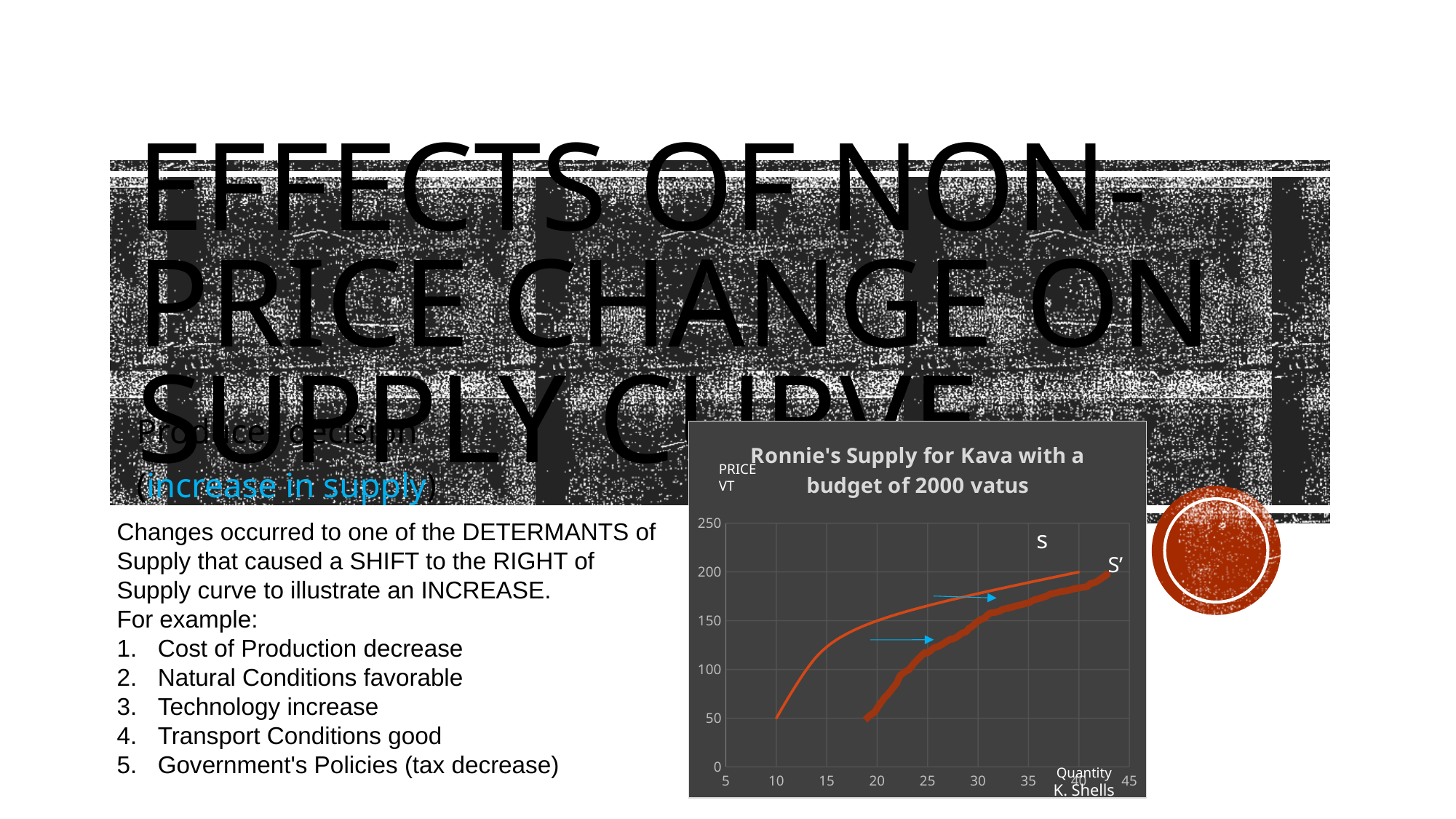
Is the price on curve S' at a quantity of 25 greater or less than 150? less What are the labels of the two curves on the chart? S and S' What is the title of the chart on the slide? Ronnie's Supply for Kava with a budget of 2000 vatus Is the price on curve S at a quantity of 30 greater or less than 150? greater Do the supply curves rise or fall as quantity increases along the x axis? rise What kind of chart is shown on the slide? line chart At a quantity of 15, is the price on curve S greater or less than 100? greater What is the highest value shown on the price (vertical) axis of the chart? 250 How many supply curves are plotted on the chart? 2 At a quantity of 25, which curve shows the higher price, S or S'? S